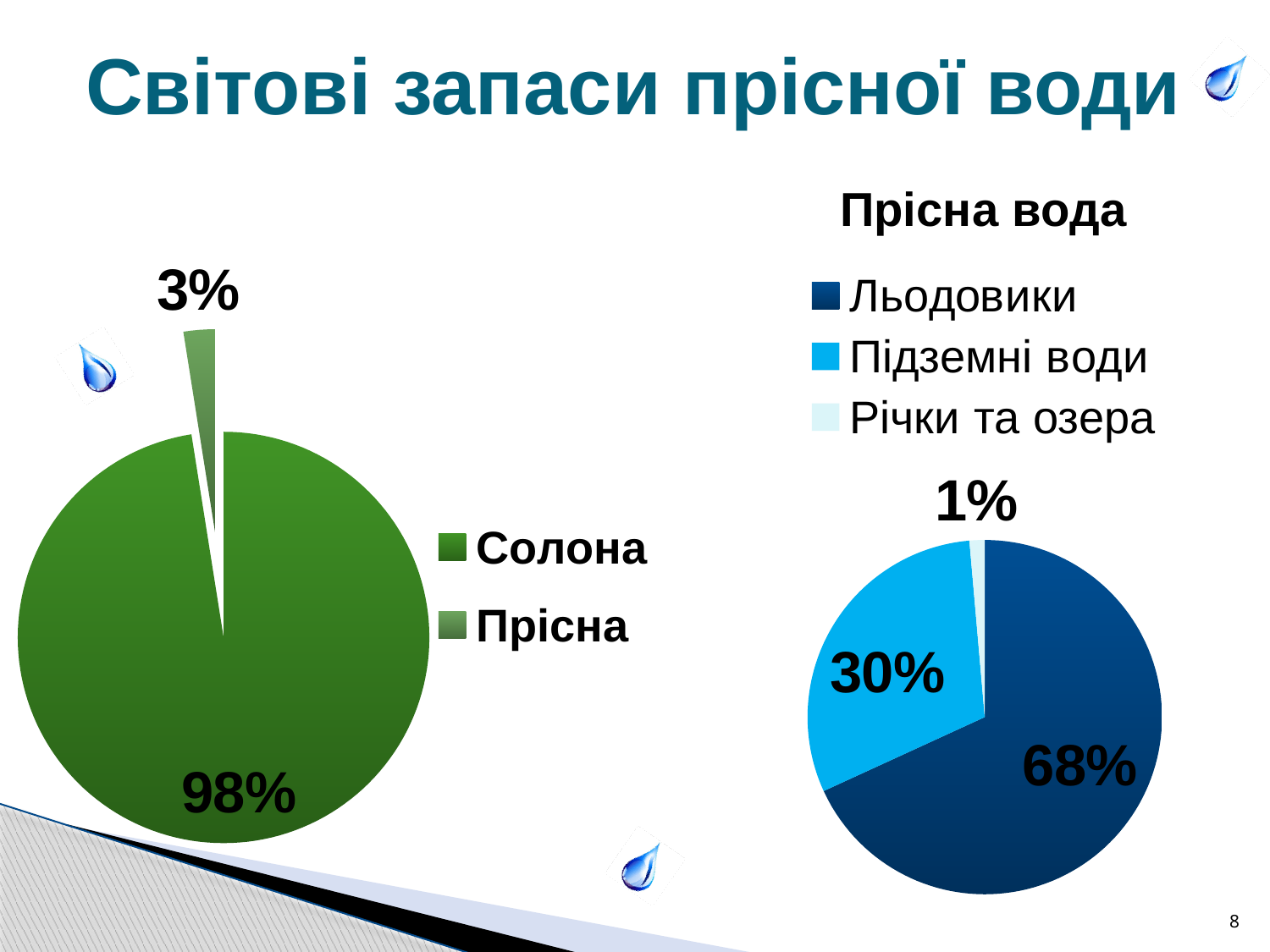
In the 'Прісна вода' pie chart, what share is labelled for Підземні води? 30% In the 'Прісна вода' pie chart, which category has the smallest slice? Річки та озера How many slices does the 'Прісна вода' pie chart have? 3 In the 'Прісна вода' pie chart, what share is labelled for Льодовики? 68% In the left pie chart, what share is labelled for Прісна? 3% What is the title of the right pie chart? Прісна вода In the 'Прісна вода' pie chart, what is the difference between the shares of Льодовики and Підземні води? 38% In the left pie chart, which category has the largest slice? Солона How many categories does the legend of the left pie chart list? 2 What type of chart is the left chart on the slide? pie chart